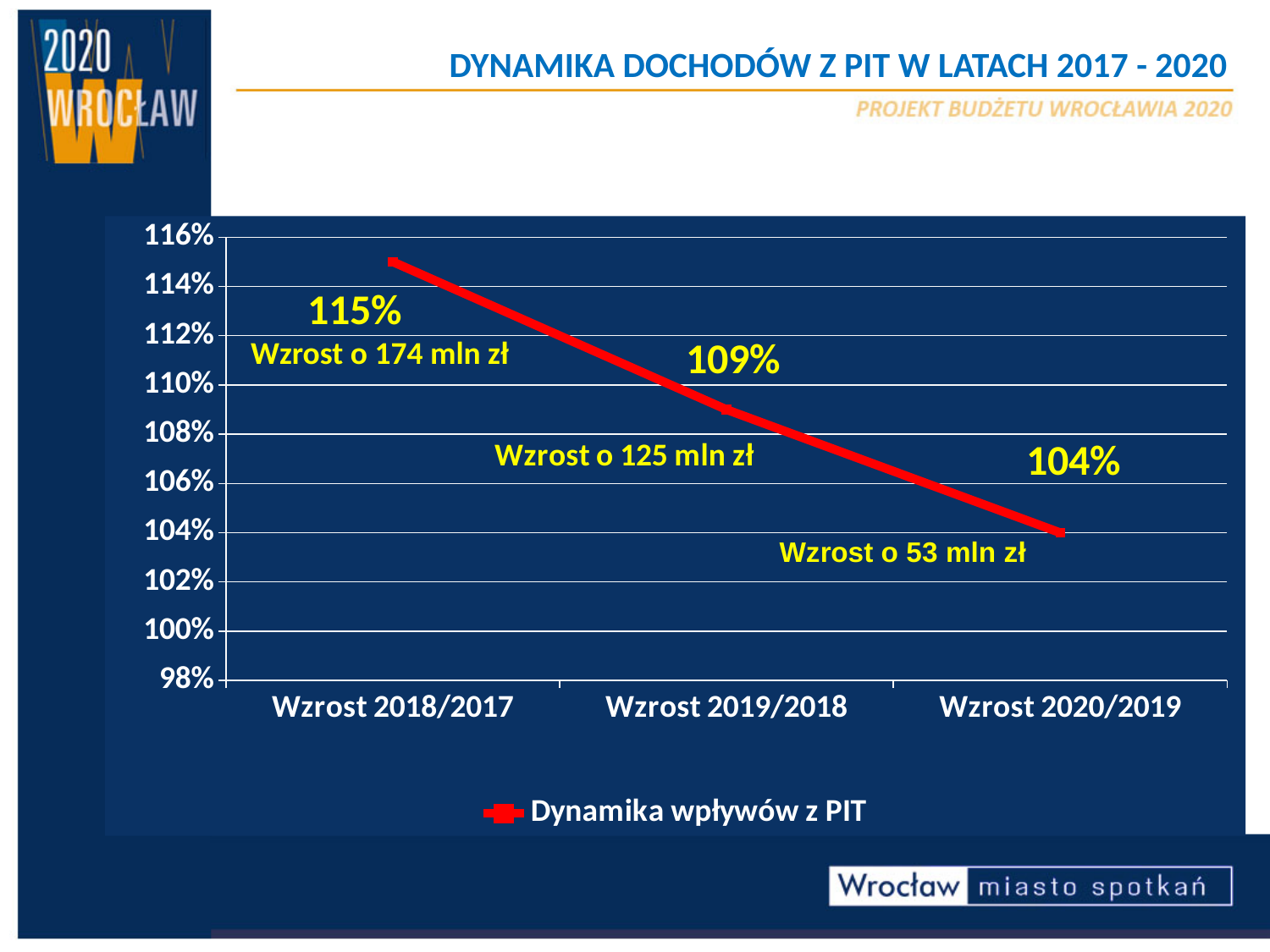
Which category has the lowest value? Wzrost 2020/2019 Is the value for Wzrost 2019/2018 greater or less than 110%? less What is the value for Wzrost 2018/2017? 115% Which is larger, the value for Wzrost 2019/2018 or Wzrost 2020/2019? Wzrost 2019/2018 Do the values rise or fall from left to right along the x axis? fall What is the difference between the values for Wzrost 2018/2017 and Wzrost 2020/2019? 11% How many categories are shown on the x axis? 3 What kind of chart is shown on the slide? line chart Which category has the highest value? Wzrost 2018/2017 What series name does the legend show? Dynamika wpływów z PIT What is the value for Wzrost 2019/2018? 109% What is the value for Wzrost 2020/2019? 104%